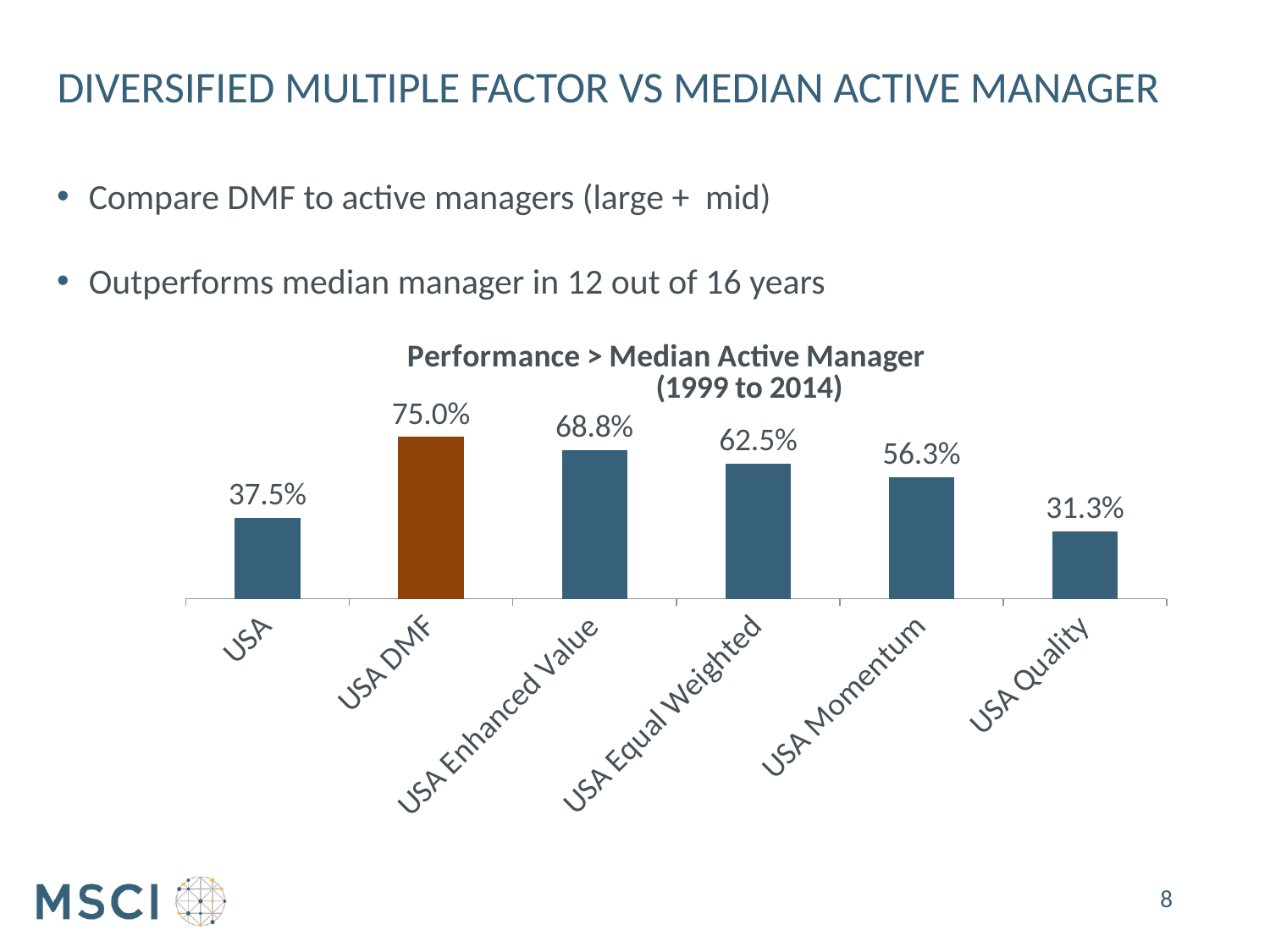
What is the value for USA Equal Weighted? 62.5% How many categories are shown on the chart? 6 Which bar is shown in a different colour (orange) from the others? USA DMF Which category has the highest value? USA DMF What is the title of the chart? Performance > Median Active Manager (1999 to 2014) Which is larger, the value for USA Momentum or the value for USA Quality? USA Momentum What is the difference between the values for USA Enhanced Value and USA Momentum? 12.5% What is the value for USA DMF? 75.0% What is the difference between the values for USA DMF and USA? 37.5% What kind of chart is shown on the slide? Bar chart Which category has the lowest value? USA Quality What is the value for USA Quality? 31.3%